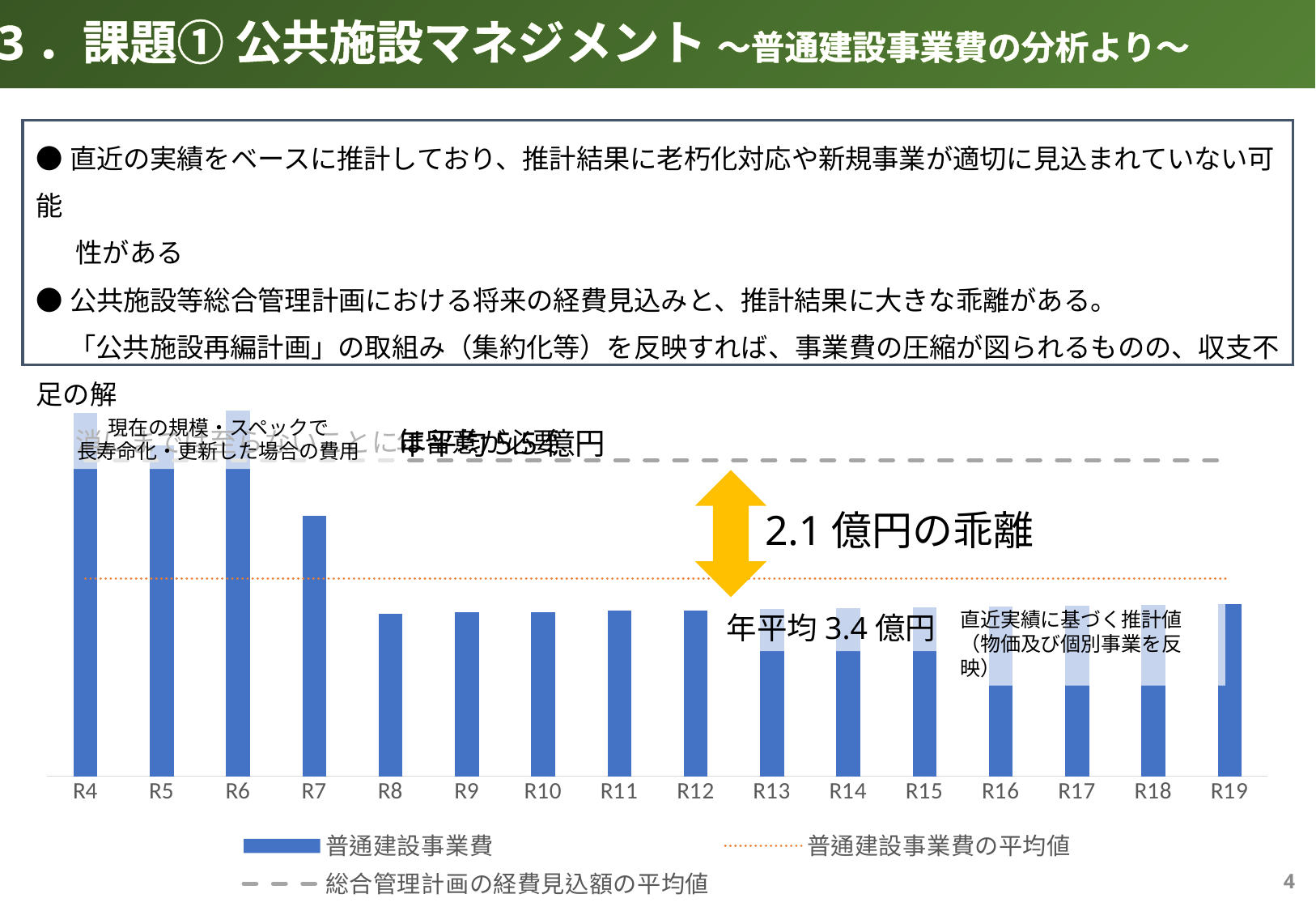
Which is larger, the bar for R7 or the bar for R8? R7 What is the size of the gap (乖離) labelled between the two average lines on the chart? 2.1 億円 What kind of chart is shown on the slide? bar and line chart (combination chart) How many entries does the chart legend list? 3 What is the annual average value of 普通建設事業費 shown on the chart? 年平均 3.4 億円 Which is larger, the bar for R4 or the bar for R7? R4 Do the bar values rise or fall from R4 to R8? fall How many categories (fiscal years) are shown on the x axis of the chart? 16 What is the first category label on the x axis of the chart? R4 What legend entry is represented by the dashed line in the chart? 総合管理計画の経費見込額の平均値